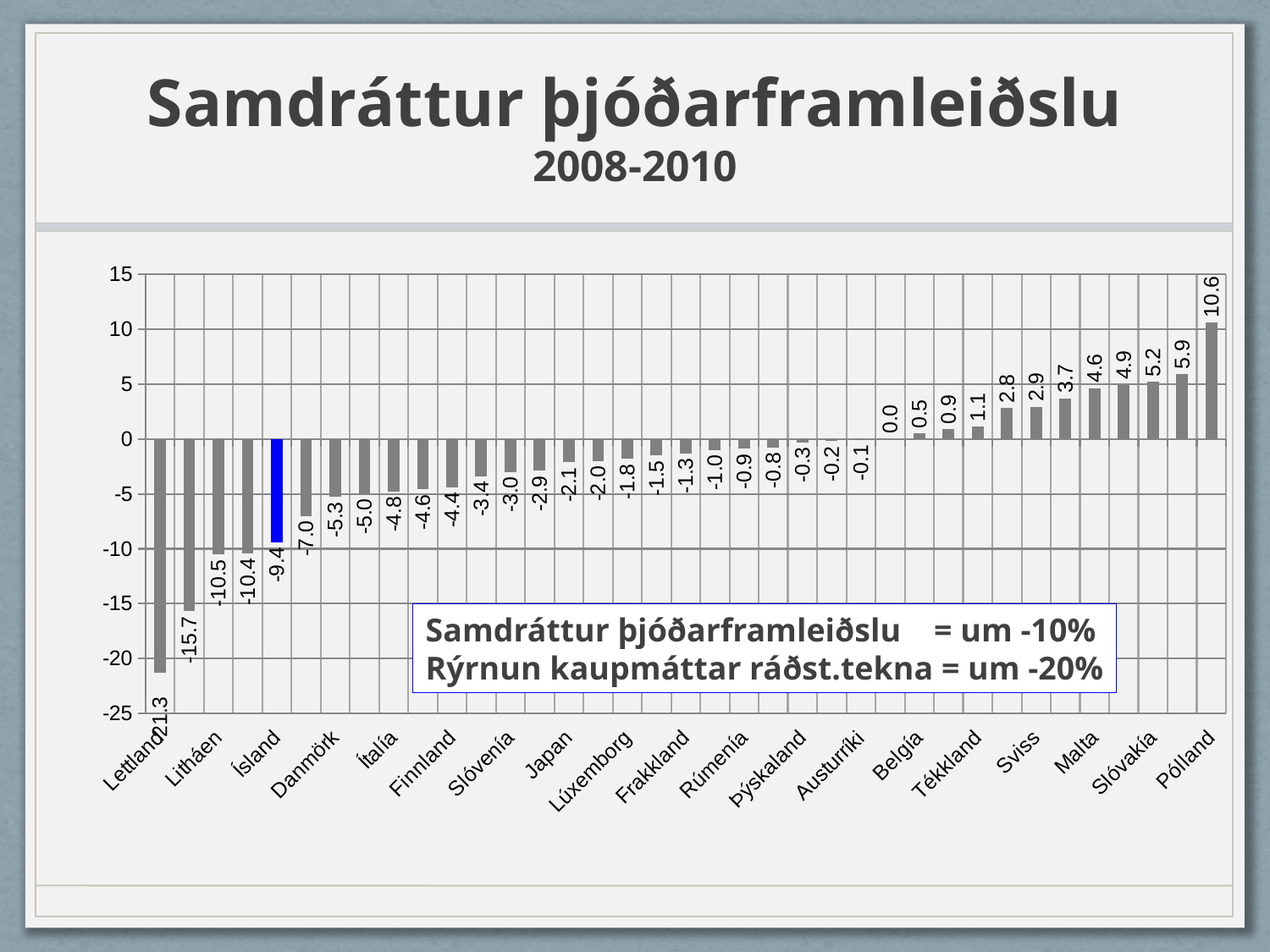
What kind of chart is shown on the slide? bar chart How many bars are plotted in the chart? 37 Do the values rise or fall from left to right along the x axis? rise Is the value for Lettland greater or less than -20? less What is the difference between the values for Pólland and Ísland? 20.0 Which country's bar is highlighted in blue? Ísland Which has the larger value, Ísland or Lettland? Ísland What is the value for Pólland? 10.6 Which country has the lowest value in the chart? Lettland Which country has the highest value in the chart? Pólland What is the value for Ísland? -9.4 What is the value for Lettland? -21.3